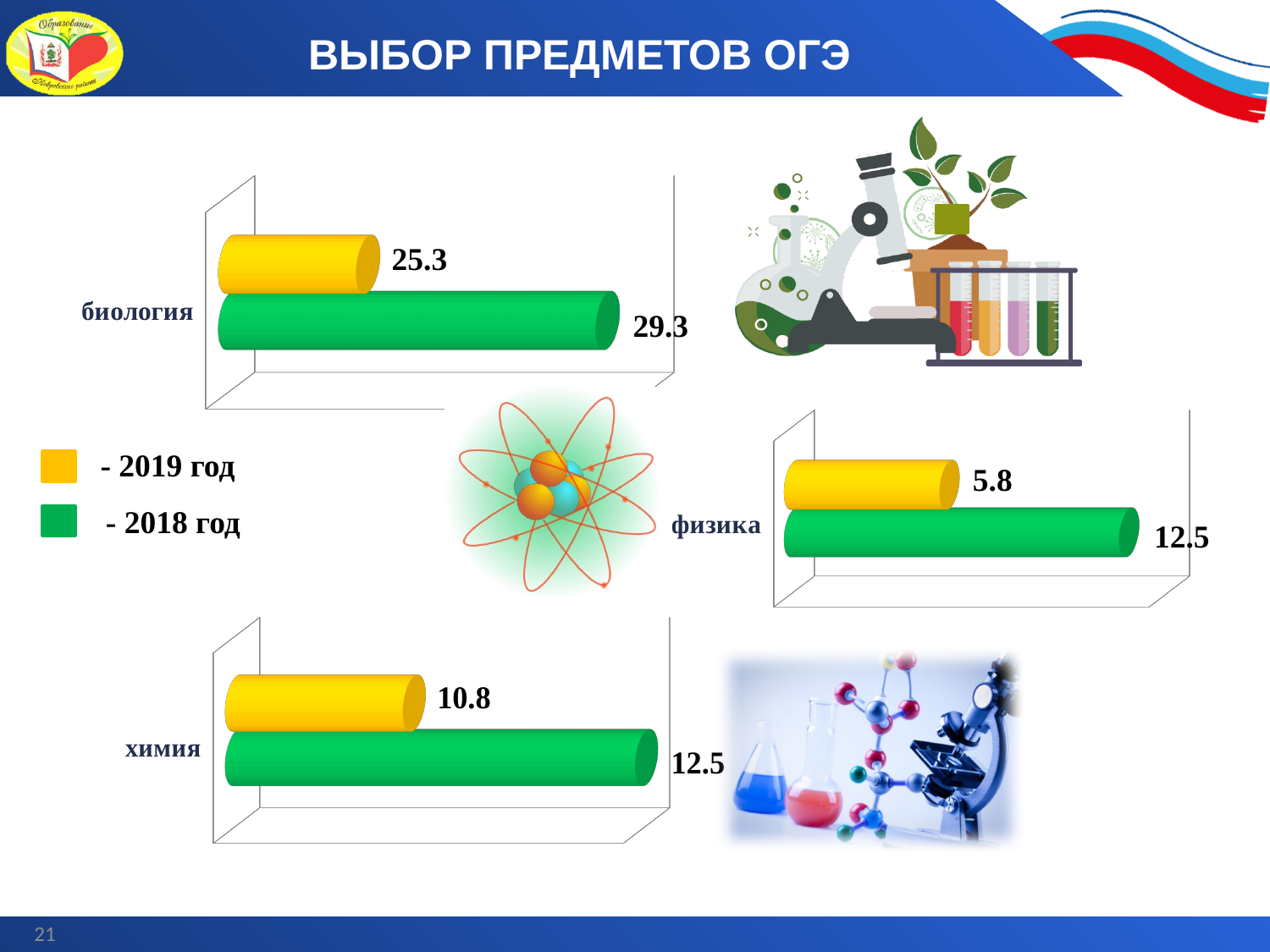
How many series does the legend on the slide list? 2 In the физика chart, what is the difference between the 2018 год and 2019 год values? 6.7 In the биология chart, what is the value for 2019 год? 25.3 Which colour represents 2019 год in the legend? yellow In the физика chart, what is the value for 2019 год? 5.8 In the химия chart, what is the value for 2018 год? 12.5 In the химия chart, which year has the larger value, 2018 год or 2019 год? 2018 год What type of chart is used for биология, физика and химия on this slide? bar chart In the химия chart, what is the value for 2019 год? 10.8 In the физика chart, what is the value for 2018 год? 12.5 In the биология chart, what is the difference between the 2018 год and 2019 год values? 4.0 In the биология chart, what is the value for 2018 год? 29.3